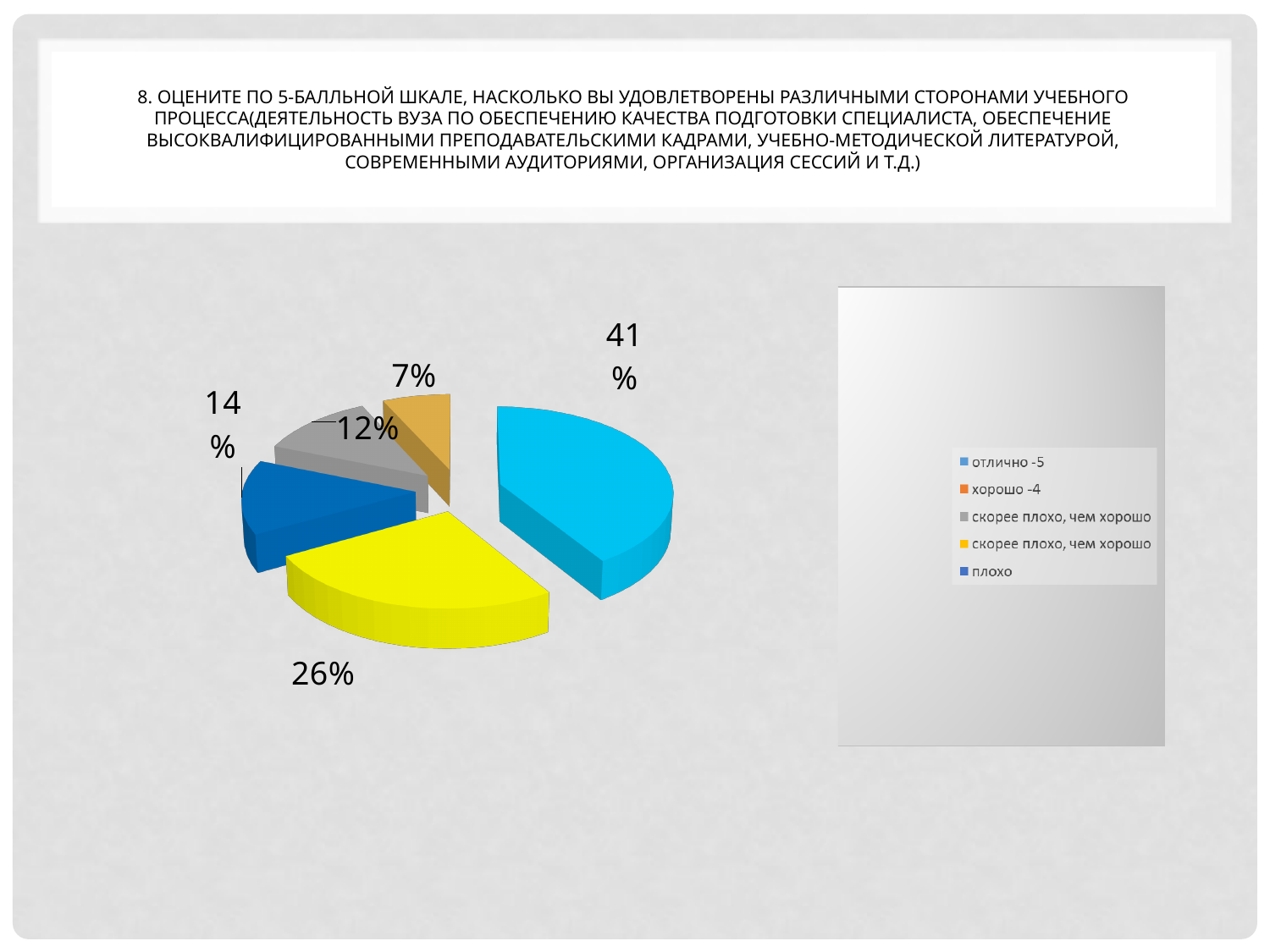
What is the difference in percentage points between the "отлично -5" slice and the "плохо" slice? 27 What percentage is shown on the yellow slice of the pie chart? 26% What kind of chart is shown on the slide? pie chart How many slices does the pie chart have? 5 Which category has the largest slice of the pie chart? отлично -5 What share of the pie does the "плохо" slice represent? 14% How many entries does the legend of the pie chart list? 5 Which slice is larger: "плохо" or "хорошо -4"? плохо What percentage is shown on the gray slice of the pie chart? 12% What share of the pie does the "отлично -5" slice represent? 41% Which category has the smallest slice of the pie chart? хорошо -4 What share of the pie does the "хорошо -4" slice represent? 7%